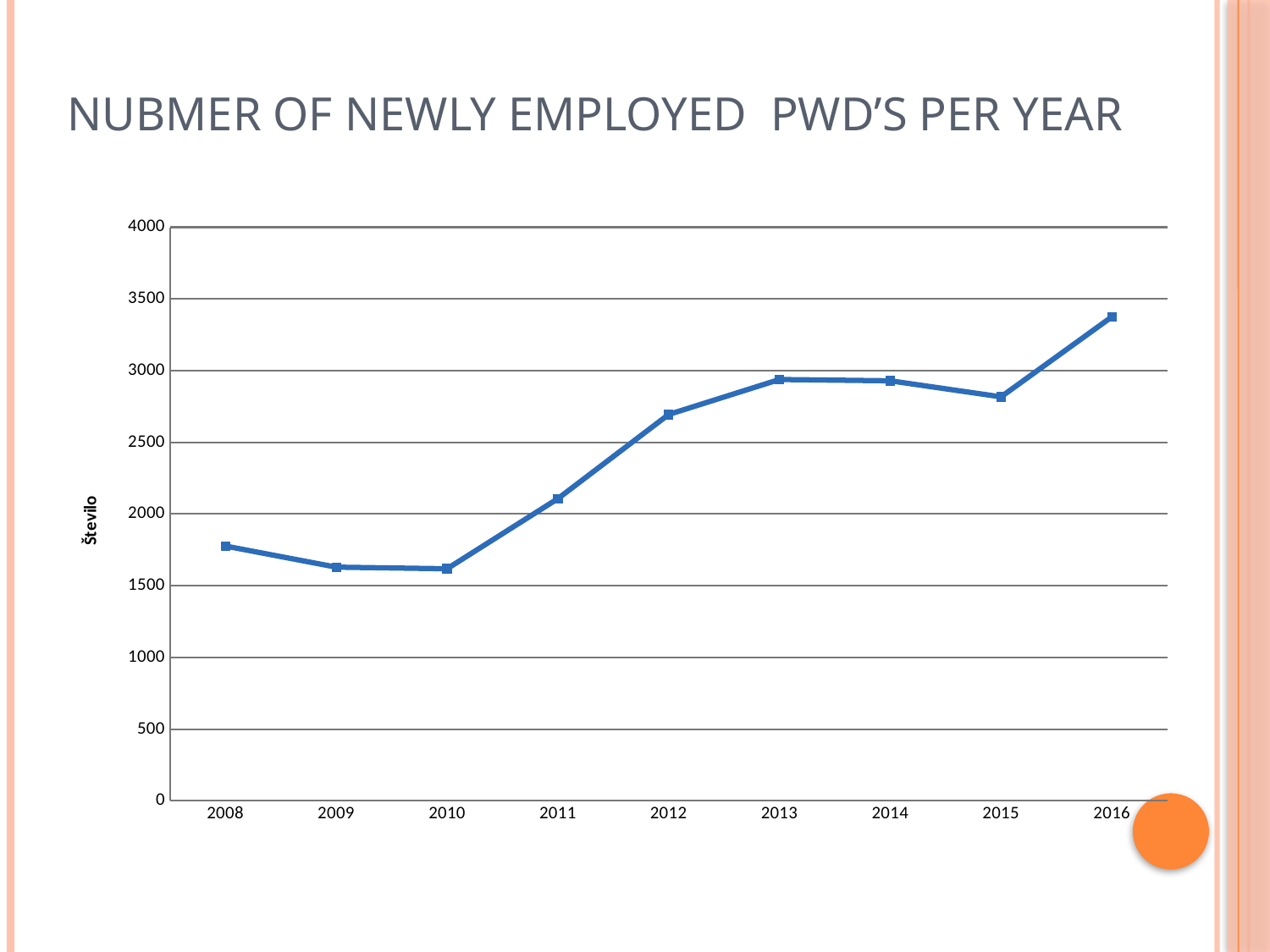
Is the value for 2011 greater or less than 2000? greater Do the values rise or fall between 2010 and 2013? rise Is the value for 2010 greater or less than 1500? greater Which year has the larger value, 2011 or 2012? 2012 Is the value for 2016 greater or less than 3000? greater Do the values rise or fall between 2008 and 2010? fall How many years are plotted along the x axis? 9 Which year has the highest number of newly employed PWD's? 2016 What kind of chart is shown on the slide? line chart What is the label on the vertical axis? Število